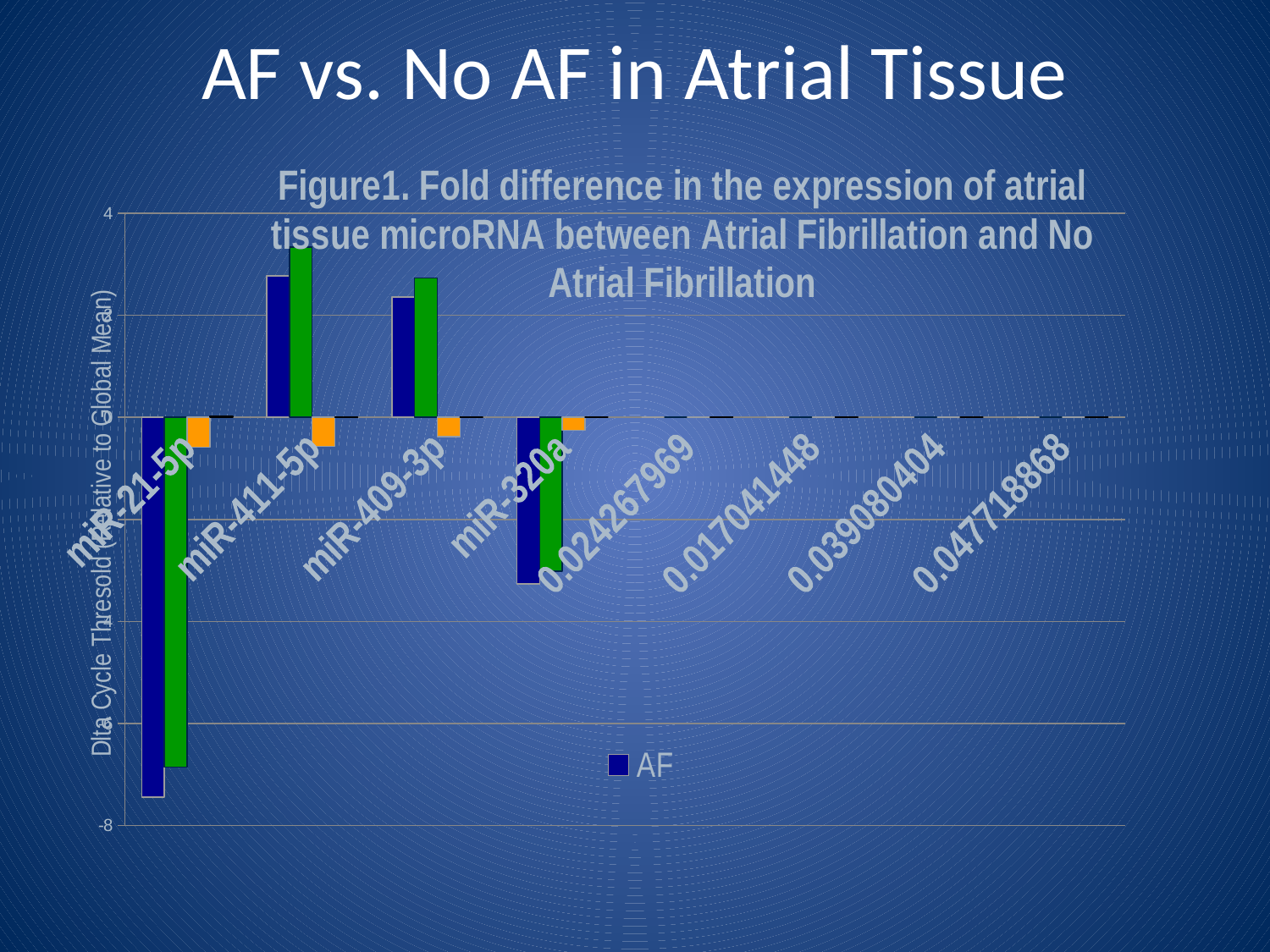
Which category has the highest blue (AF) bar? miR-411-5p Is the blue (AF) bar for miR-320a greater or less than -2? less For miR-411-5p, which bar is taller, the blue bar or the green bar? the green bar What is the title of the chart? Figure1. Fold difference in the expression of atrial tissue microRNA between Atrial Fibrillation and No Atrial Fibrillation How many categories on the x axis have visible bars plotted? 4 Which is lower, the blue (AF) bar for miR-21-5p or the blue (AF) bar for miR-320a? miR-21-5p How many series does the legend list? 1 Is the blue (AF) bar for miR-21-5p greater or less than -6? less What is the only entry shown in the legend? AF What kind of chart is shown on the slide? bar chart Which category has the lowest blue (AF) bar? miR-21-5p Is the green bar for miR-411-5p greater or less than 2? greater